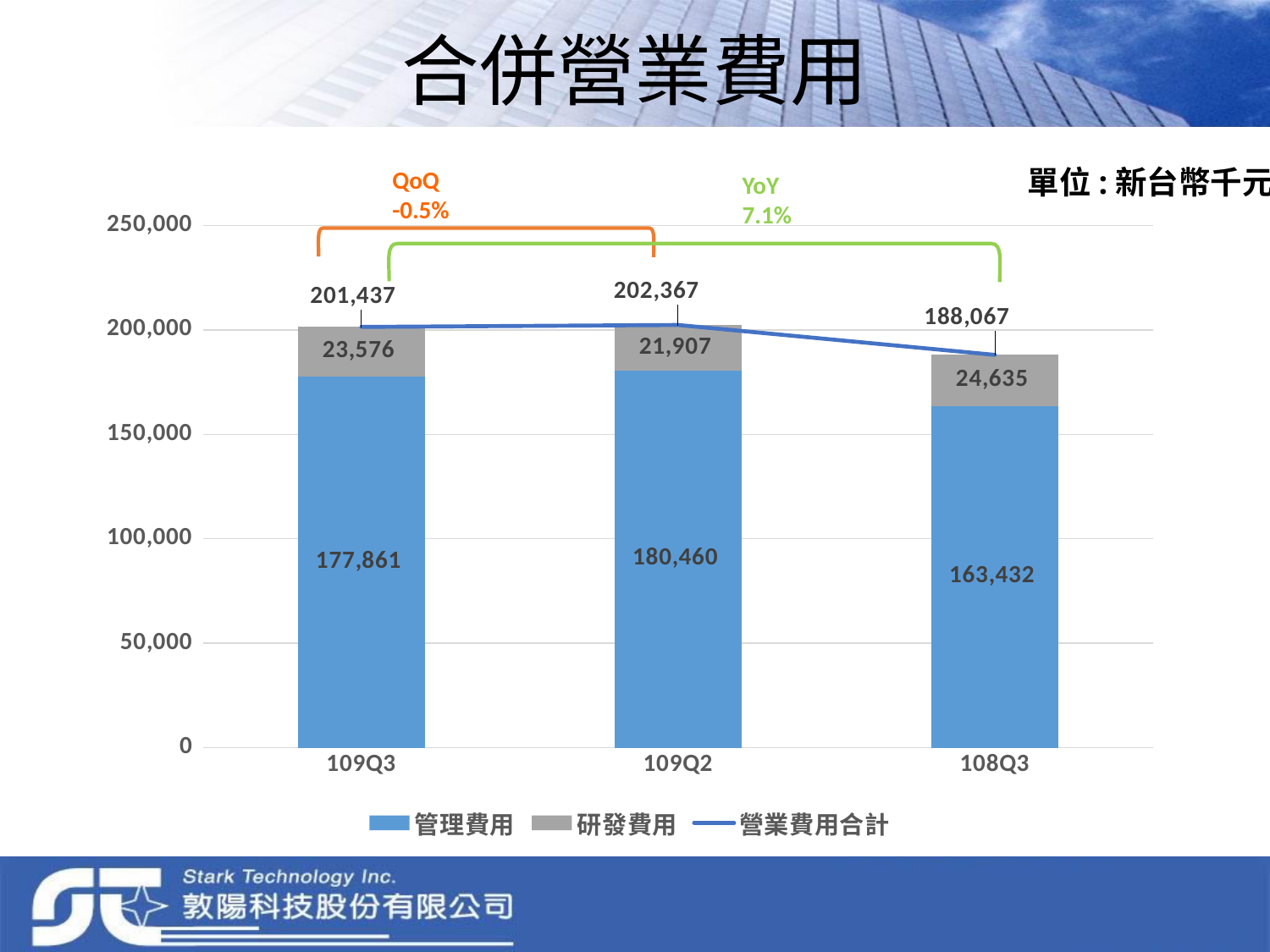
What kind of chart is shown on the slide? Stacked bar chart with a line What is the value of 研發費用 for 108Q3? 24,635 Which quarter has the highest 營業費用合計? 109Q2 What is the QoQ change shown on the chart? -0.5% What is the value of 管理費用 for 109Q3? 177,861 What is the 營業費用合計 value for 109Q2? 202,367 Which is larger, 研發費用 for 109Q3 or for 109Q2? 109Q3 Which quarter has the lowest 管理費用? 108Q3 What is the difference in 管理費用 between 109Q2 and 109Q3? 2,599 How many series does the legend list? 3 How many quarters are shown on the x axis? 3 Is the 營業費用合計 for 108Q3 greater or less than 200,000? less